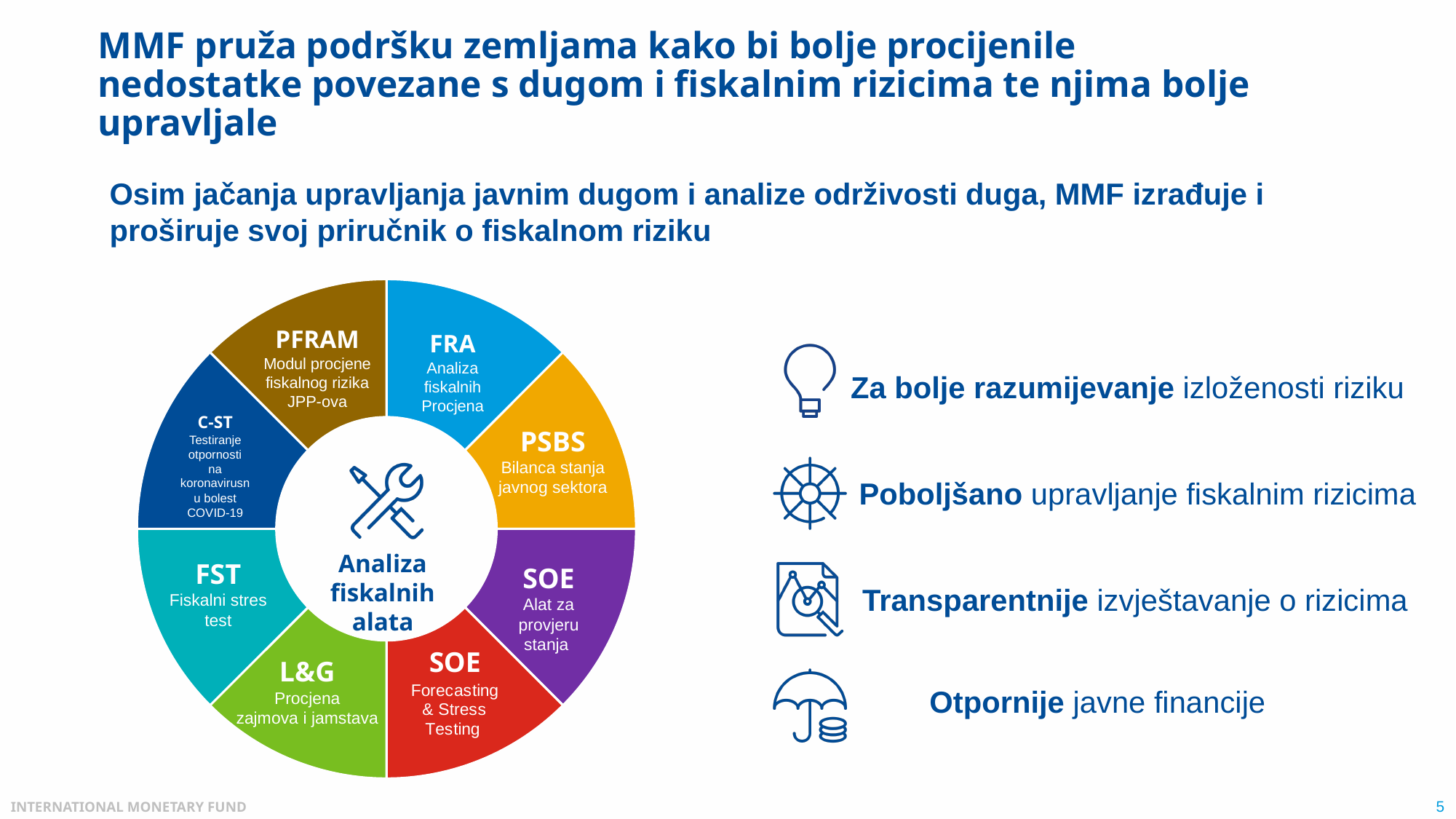
What colour is the PSBS segment of the ring diagram? Orange/yellow What description is given for the PSBS segment of the ring diagram? Bilanca stanja javnog sektora What description is given for the L&G segment of the ring diagram? Procjena zajmova i jamstava How many segments does the ring diagram on the left of the slide have? 8 How many segments of the ring diagram are labelled SOE? 2 What text appears in the centre of the ring diagram? Analiza fiskalnih alata Which segment of the ring diagram is described as "Fiskalni stres test"? FST Which segment of the ring diagram is described as "Modul procjene fiskalnog rizika JPP-ova"? PFRAM